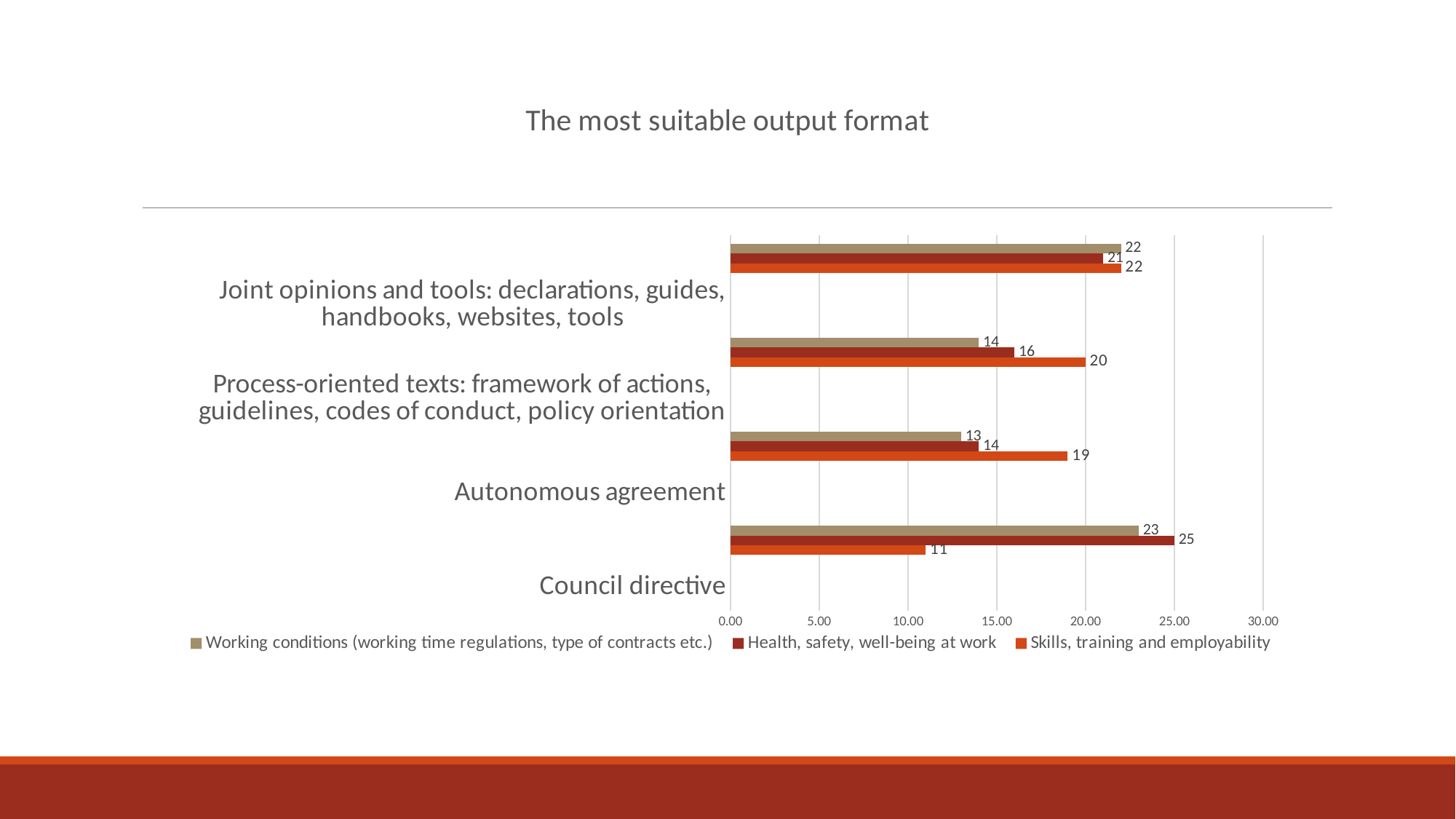
What is the value for Working conditions for Autonomous agreement? 13 What is the title of the chart? The most suitable output format How many series does the legend list? 3 Is the Health, safety, well-being at work value for Joint opinions and tools greater or less than 15.00? greater Which category has the lowest value for Skills, training and employability? Council directive For Autonomous agreement, which is larger: the Skills, training and employability value or the Working conditions value? Skills, training and employability What is the difference between the Working conditions and Skills, training and employability values for Council directive? 12 How many output format categories are shown on the chart? 4 What is the value for Health, safety, well-being at work for Council directive? 25 Which category has the highest value for Health, safety, well-being at work? Council directive What is the value for Skills, training and employability for Process-oriented texts? 20 What type of chart is shown on the slide? Bar chart